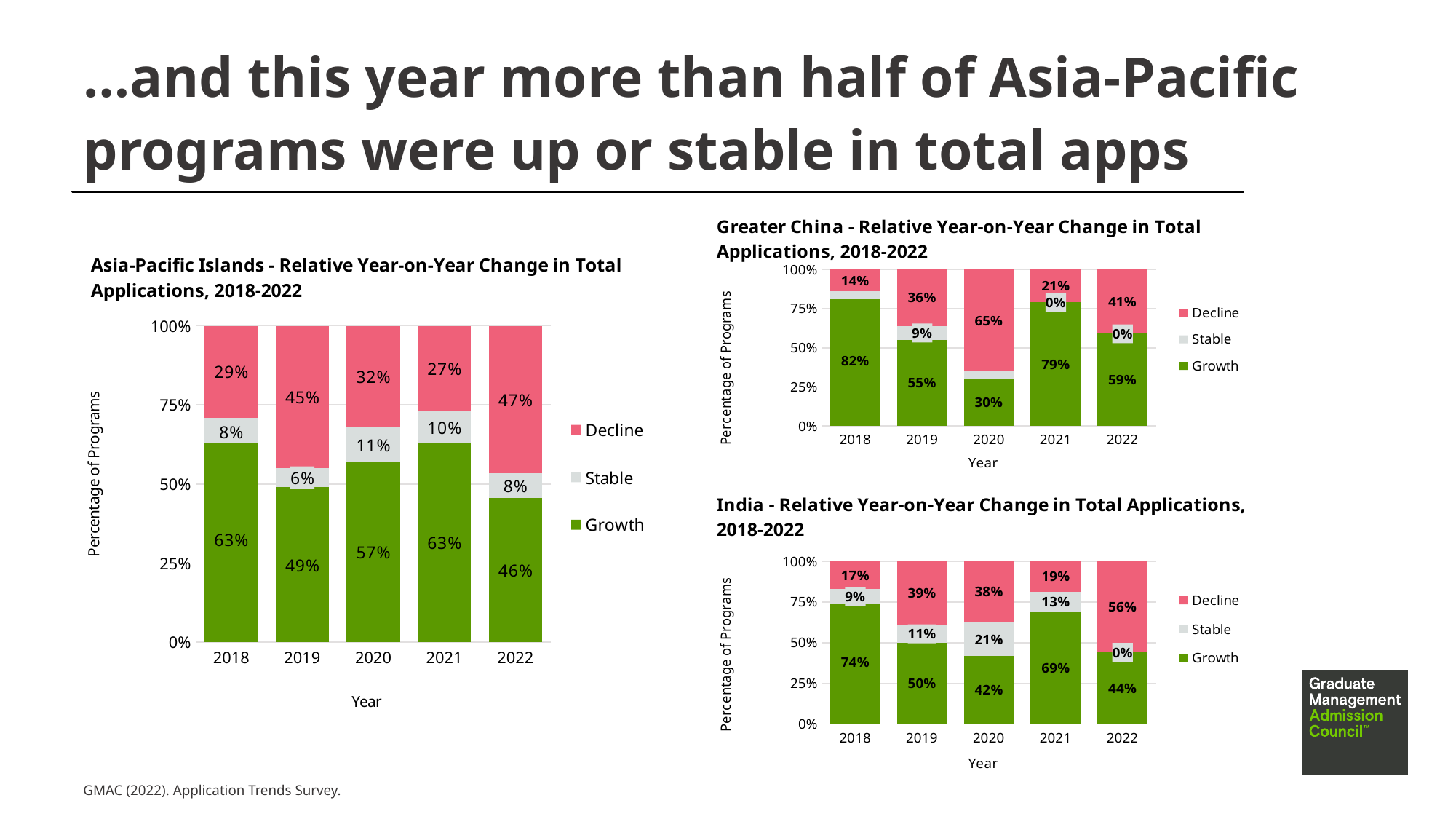
In the India chart, which year has the highest Stable share? 2020 In the Asia-Pacific Islands chart, what percentage of programs reported Growth in 2022? 46% In the Asia-Pacific Islands chart, what is the difference between the Decline share in 2022 and in 2021? 20% In the Greater China chart, what is the Stable share in 2021? 0% In the India chart, is the Growth share larger in 2018 or in 2021? 2018 How many series does the legend of the India chart list? 3 In the Asia-Pacific Islands chart, which year has the highest Stable share? 2020 In the Greater China chart, what percentage of programs reported Growth in 2020? 30% In the Greater China chart, which year has the lowest Growth share? 2020 What type of chart is the Asia-Pacific Islands chart? Stacked bar chart In the Asia-Pacific Islands chart, what percentage of programs reported Decline in 2019? 45% In the India chart, what percentage of programs reported Decline in 2022? 56%